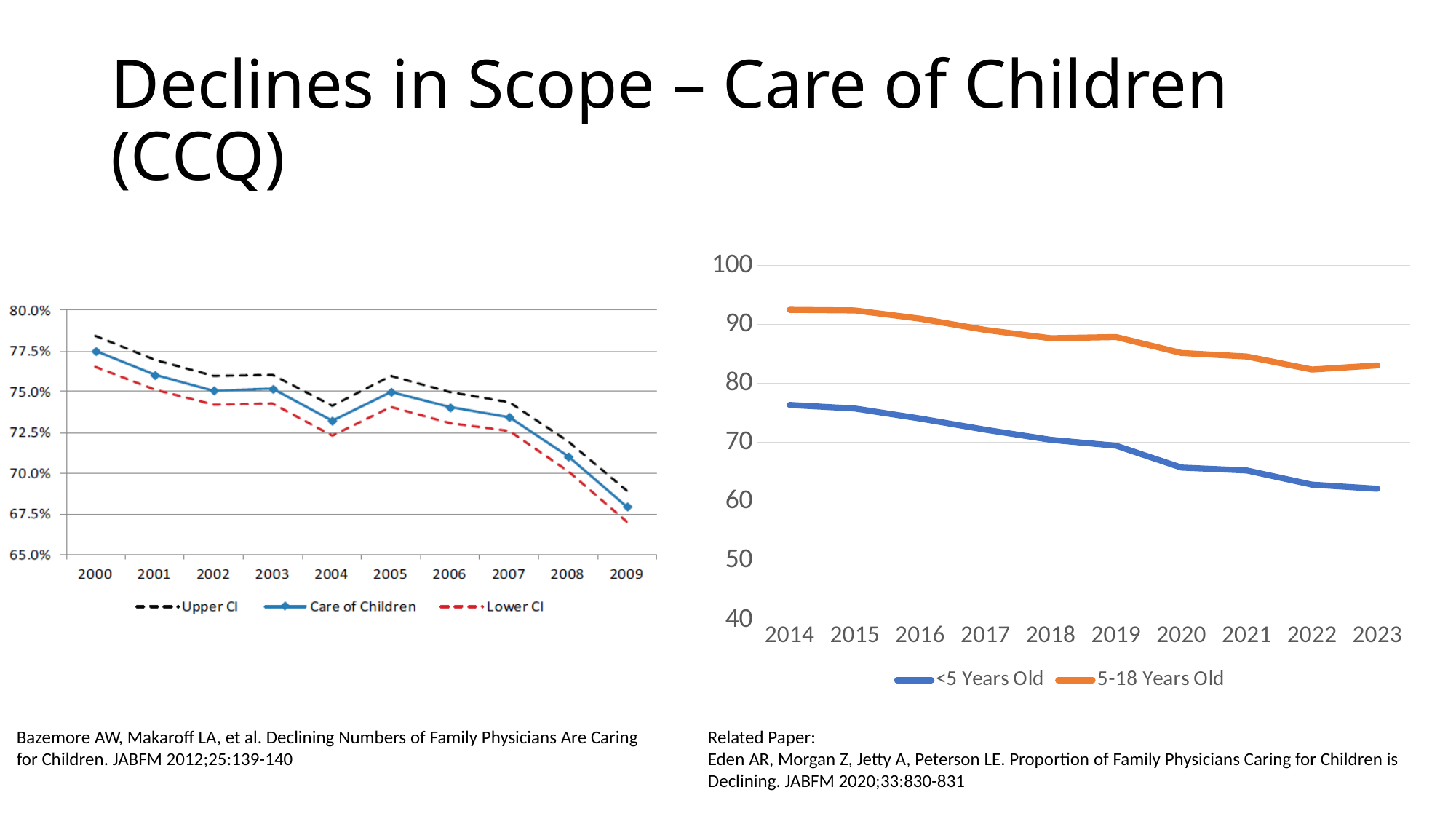
How many series does the legend of the left chart list? 3 How many years are shown on the x axis of the right chart? 10 In the right chart, is the value for <5 Years Old in 2014 greater or less than 70? greater What kind of chart is the left chart (2000–2009)? line chart In the right chart, is the value for 5-18 Years Old in 2023 greater or less than 90? less In the right chart, which colour is the <5 Years Old line? blue In the left chart, which year has the lowest Care of Children value? 2009 What kind of chart is the right chart (2014–2023)? line chart In the right chart, which series is higher in 2020, <5 Years Old or 5-18 Years Old? 5-18 Years Old In the left chart, is the Care of Children value for 2009 greater or less than 70.0%? less How many series does the legend of the right chart list? 2 In the left chart, does the Care of Children line rise or fall from 2000 to 2009? fall